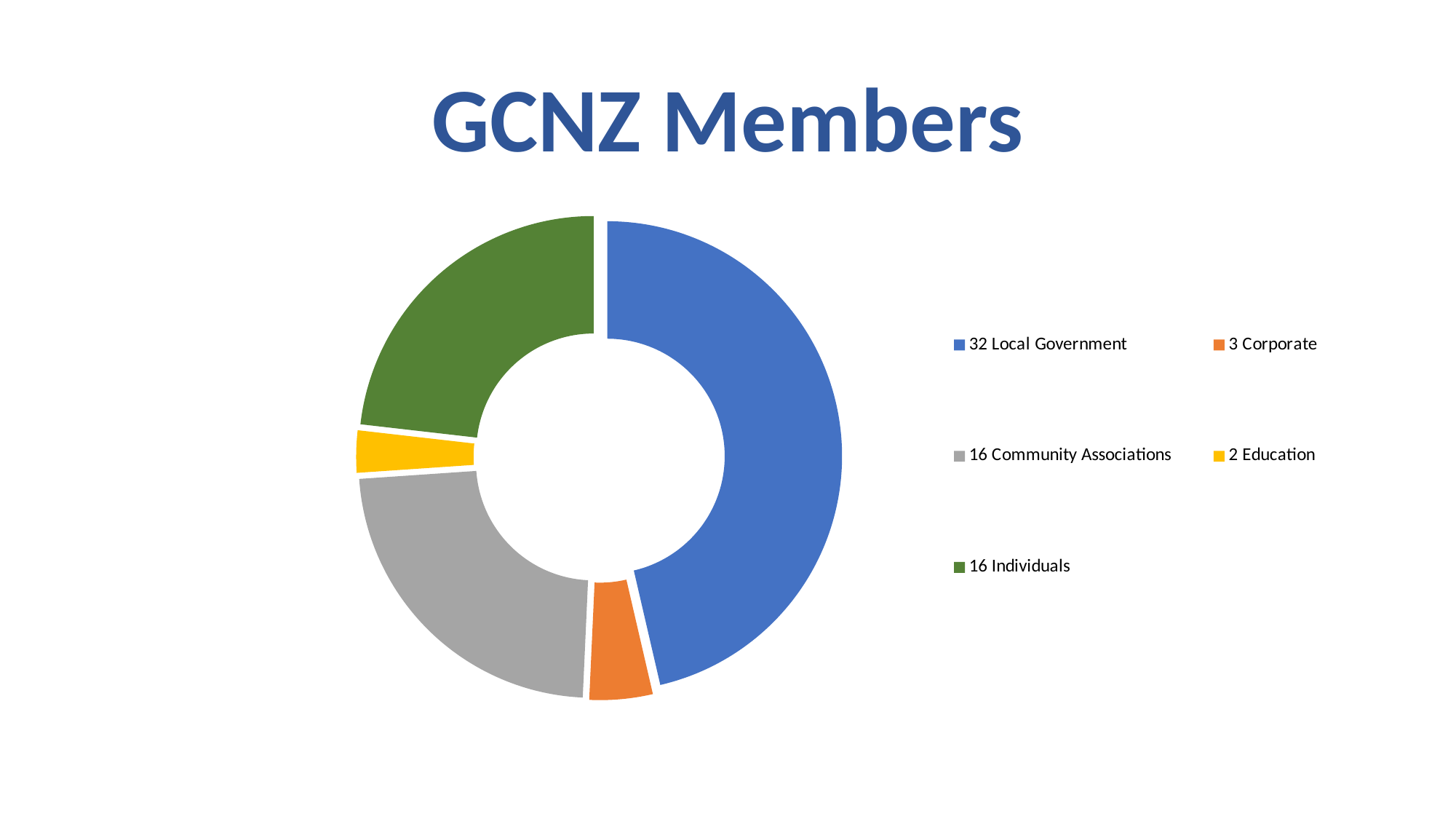
What is the title of the chart? GCNZ Members How many Local Government members are shown in the legend? 32 How many categories does the chart show? 5 What is the difference between the number of Local Government members and the number of Individuals? 16 Which category has the smallest number of members? Education How many Community Associations members are shown in the legend? 16 How many Education members are shown in the legend? 2 Which has more members, Local Government or Individuals? Local Government Which category has the largest number of members? Local Government How many Corporate members are shown in the legend? 3 What is the total number of members across all categories in the chart? 69 What kind of chart is shown on the slide? Doughnut (pie) chart